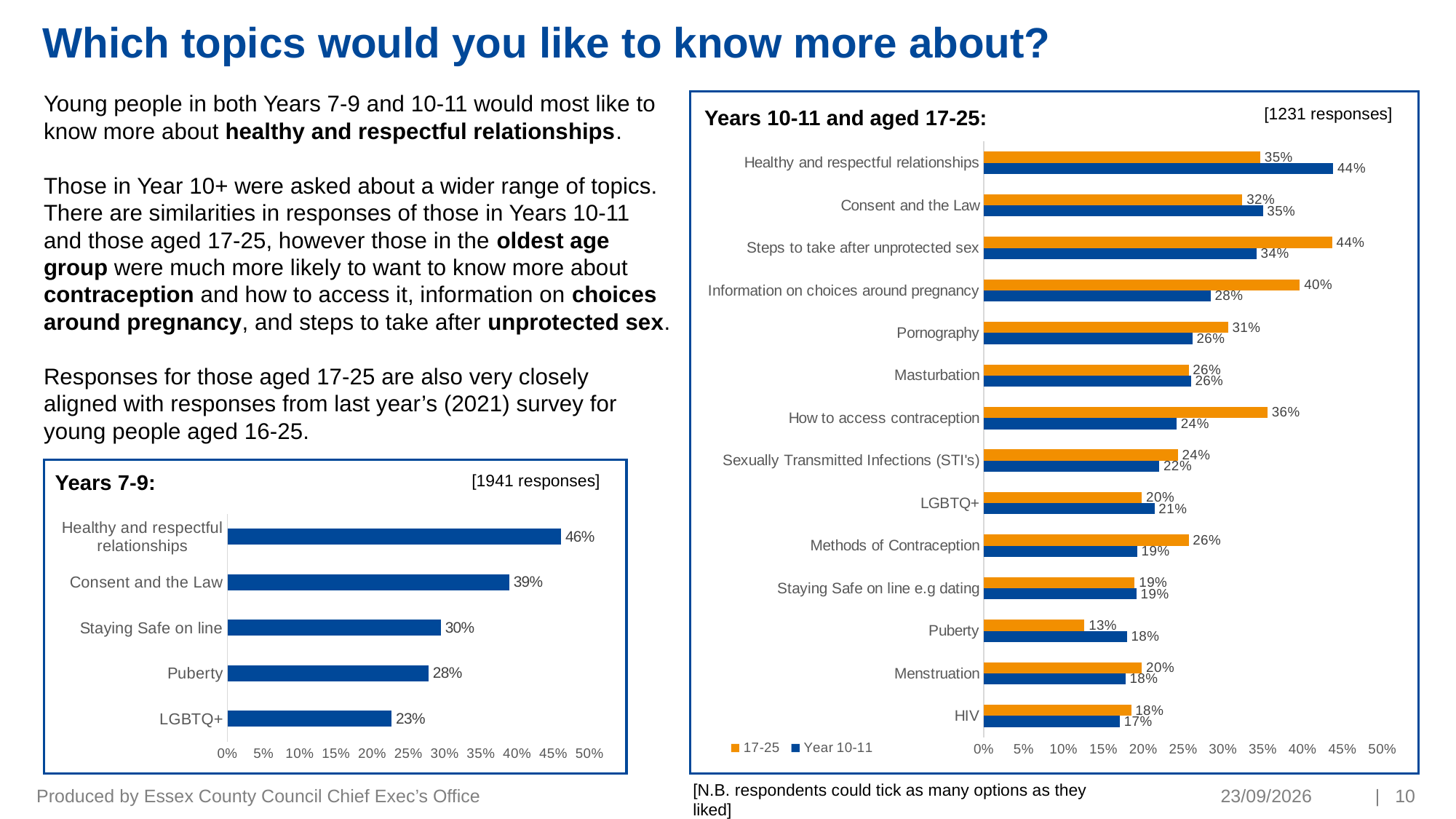
In the 'Years 7-9' chart, what is the value for Consent and the Law? 39% In the 'Years 10-11 and aged 17-25' chart, which is larger for How to access contraception: the 17-25 value or the Year 10-11 value? 17-25 What kind of chart is the 'Years 7-9' chart? Bar chart In the 'Years 10-11 and aged 17-25' chart, what is the difference between the 17-25 and Year 10-11 values for Information on choices around pregnancy? 12% In the 'Years 7-9' chart, which topic has the lowest value? LGBTQ+ In the 'Years 7-9' chart, what is the difference between Healthy and respectful relationships and Puberty? 18% In the 'Years 7-9' chart, how many topics are shown? 5 In the 'Years 10-11 and aged 17-25' chart, which topic has the lowest 17-25 value? Puberty In the 'Years 10-11 and aged 17-25' chart, which topic has the highest Year 10-11 value? Healthy and respectful relationships In the 'Years 10-11 and aged 17-25' chart, what is the 17-25 value for Steps to take after unprotected sex? 44% In the 'Years 10-11 and aged 17-25' chart, how many series does the legend list? 2 In the 'Years 10-11 and aged 17-25' chart, what is the Year 10-11 value for Information on choices around pregnancy? 28%